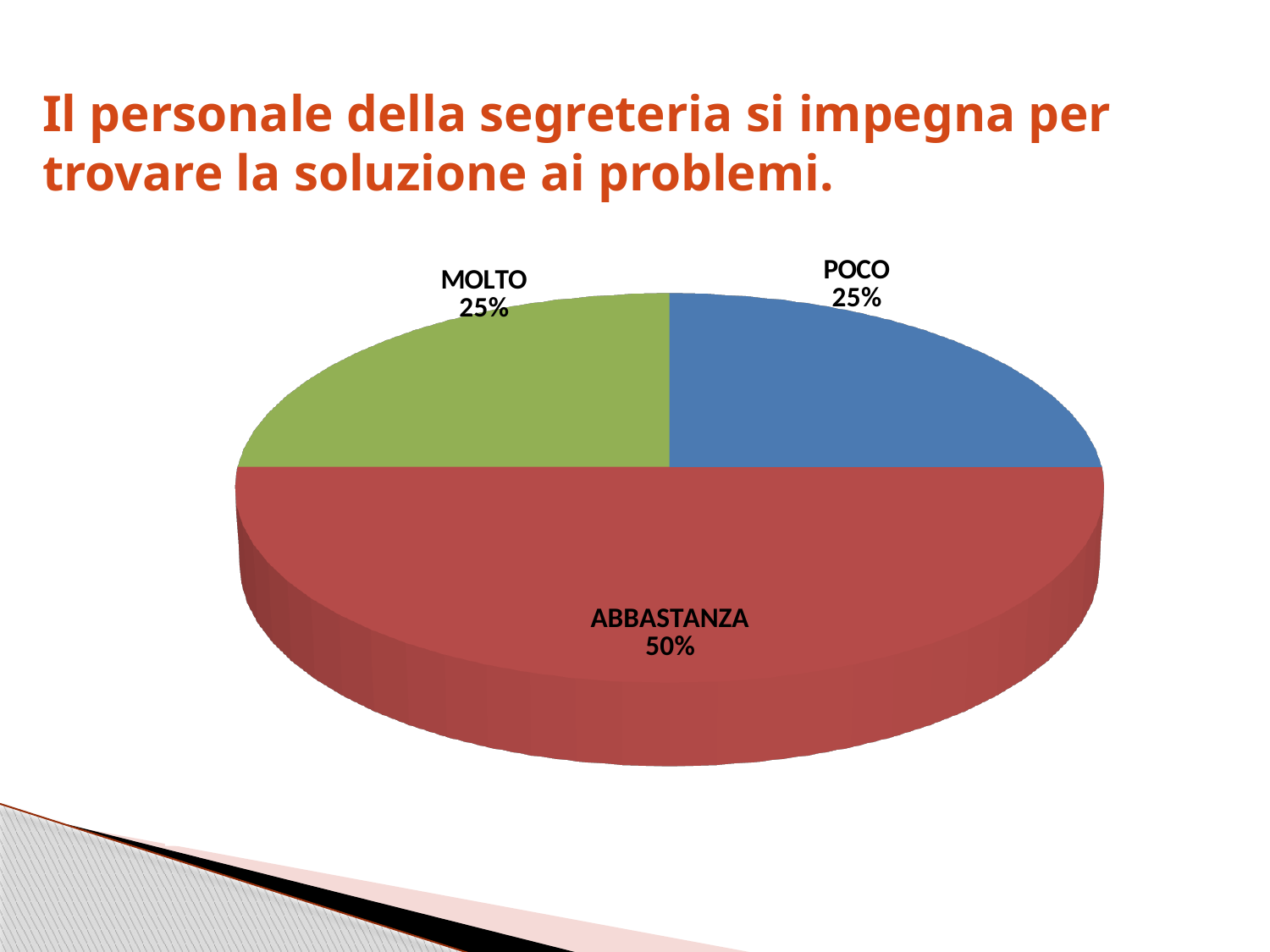
What is the title of the slide above the chart? Il personale della segreteria si impegna per trovare la soluzione ai problemi. What share of the pie does MOLTO have? 25% Which is larger, the slice for ABBASTANZA or the slice for POCO? ABBASTANZA Which category has the largest slice of the pie? ABBASTANZA How many slices does the pie chart have? 3 What share of the pie does ABBASTANZA have? 50% What share of the pie does POCO have? 25% What kind of chart is shown on the slide? Pie chart What is the combined share of the MOLTO and POCO slices? 50% What is the difference in percentage points between the ABBASTANZA slice and the MOLTO slice? 25% What colour is the ABBASTANZA slice? Red